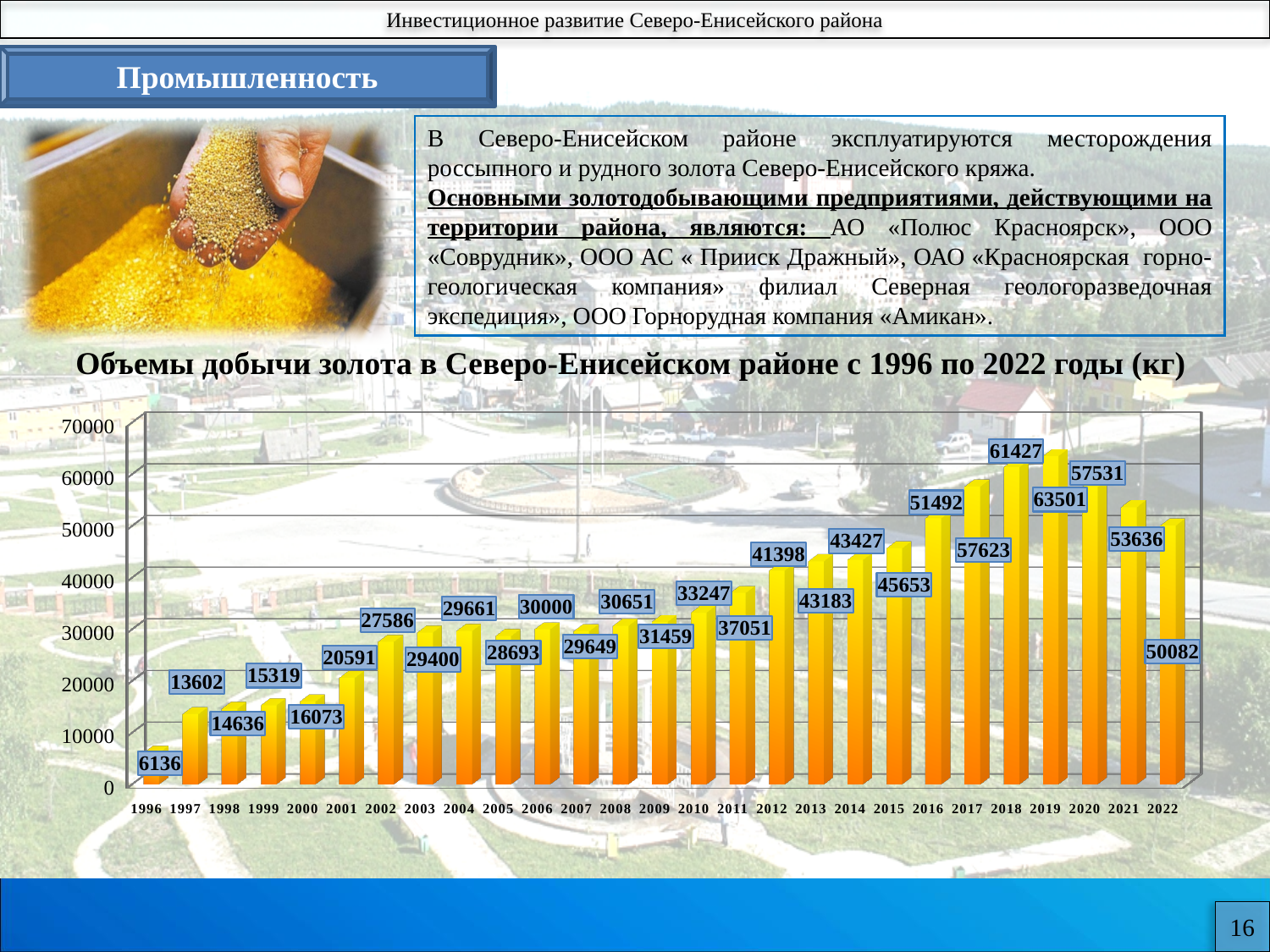
Which year had a larger gold production volume, 2017 or 2020? 2017 What was the gold production volume in 2012? 41398 Which year had the highest gold production volume? 2019 What was the gold production volume in 1996? 6136 How many years are shown on the x axis of the chart? 27 Is the gold production volume for 2016 greater or less than 50000? greater What type of chart is shown on the slide? bar chart Which year had the lowest gold production volume? 1996 What is the difference between the gold production volumes in 2019 and 2018? 2074 What was the gold production volume in 2022? 50082 What is the title of the chart? Объемы добычи золота в Северо-Енисейском районе с 1996 по 2022 годы (кг) Did gold production generally rise or fall from 1996 to 2019? rise